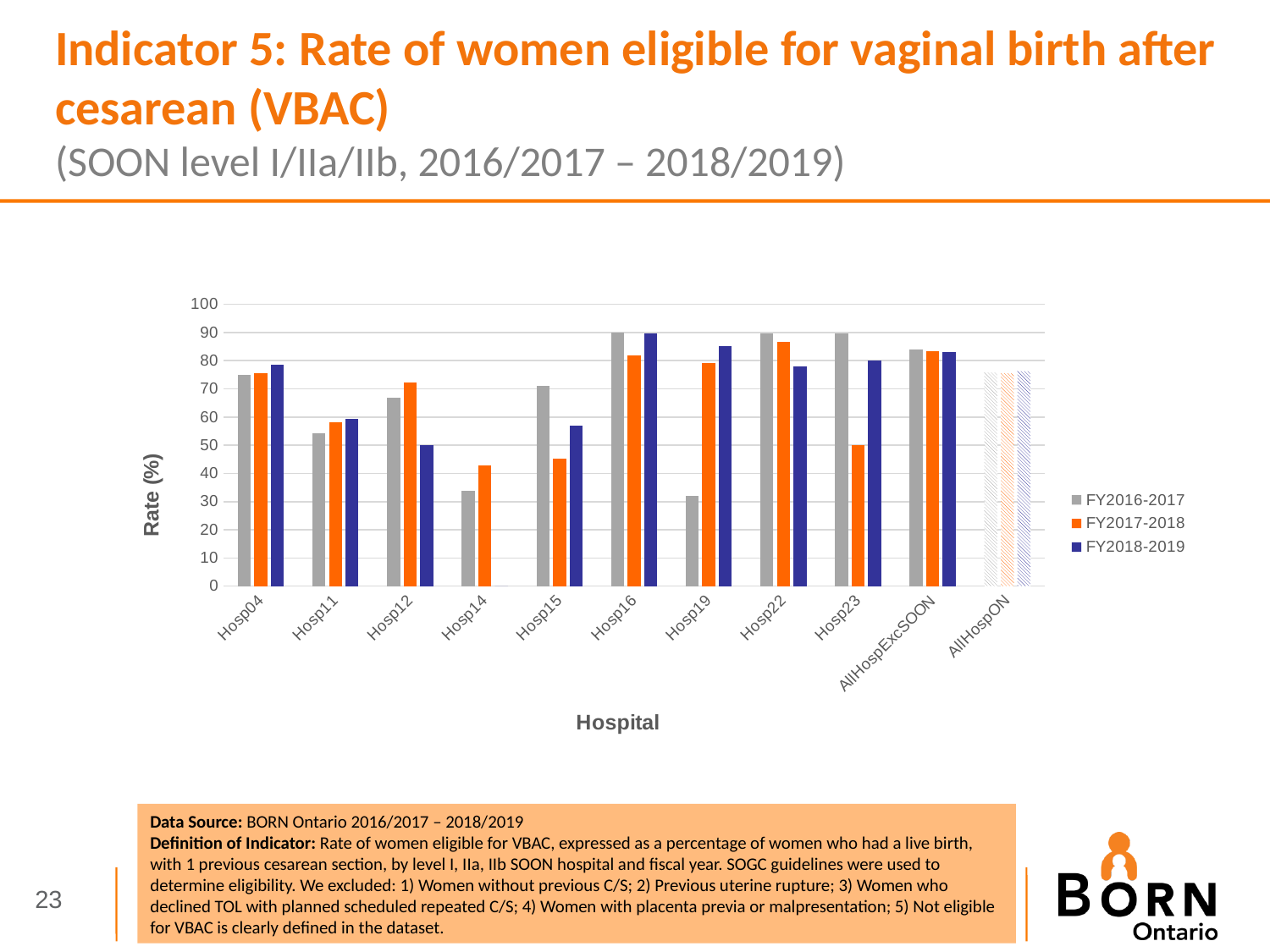
Is the FY2016-2017 value for Hosp15 greater or less than 60? greater Is the FY2016-2017 value for Hosp19 greater or less than 40? less For Hosp19, which is larger: the FY2016-2017 value or the FY2018-2019 value? FY2018-2019 What is the title of the vertical axis? Rate (%) How many series does the legend list? 3 For Hosp23, which is larger: the FY2016-2017 value or the FY2017-2018 value? FY2016-2017 Which hospital has the highest FY2018-2019 value? Hosp16 Do the values for Hosp22 rise or fall from FY2016-2017 to FY2018-2019? fall What kind of chart is shown on the slide? Bar chart Is the FY2016-2017 value for Hosp16 greater or less than 80? greater How many hospital categories are shown on the x axis? 11